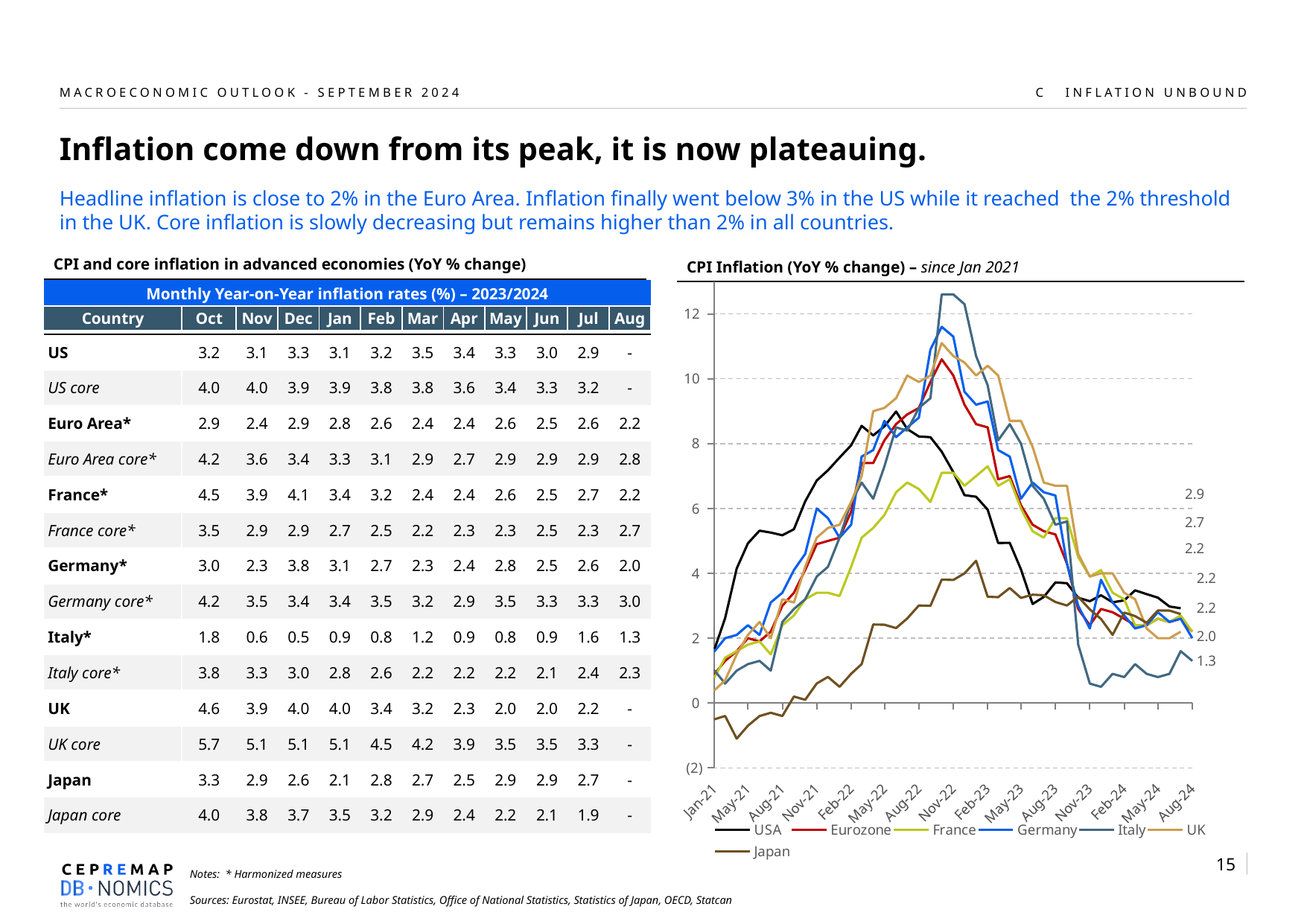
In the CPI Inflation chart, is the peak of the France line greater or less than 8? less In the CPI Inflation chart, is Japan's value at Jan-21 greater or less than 0? less In the CPI Inflation chart, do the lines generally rise or fall between Nov-22 and Aug-24? fall In the CPI Inflation chart, which series ends lowest at Aug-24? Italy What kind of chart is the 'CPI Inflation (YoY % change) – since Jan 2021' chart? line chart In the CPI Inflation chart, which series has the lowest values during 2021? Japan How many series does the legend of the CPI Inflation chart list? 7 In the CPI Inflation chart, which series reaches the highest peak? Italy In the CPI Inflation chart, is the peak of the Germany line greater or less than 10? greater In the CPI Inflation chart, which colour is used for the USA series? black In the CPI Inflation chart, what is the end value labelled for the lowest line (Italy) at Aug-24? 1.3